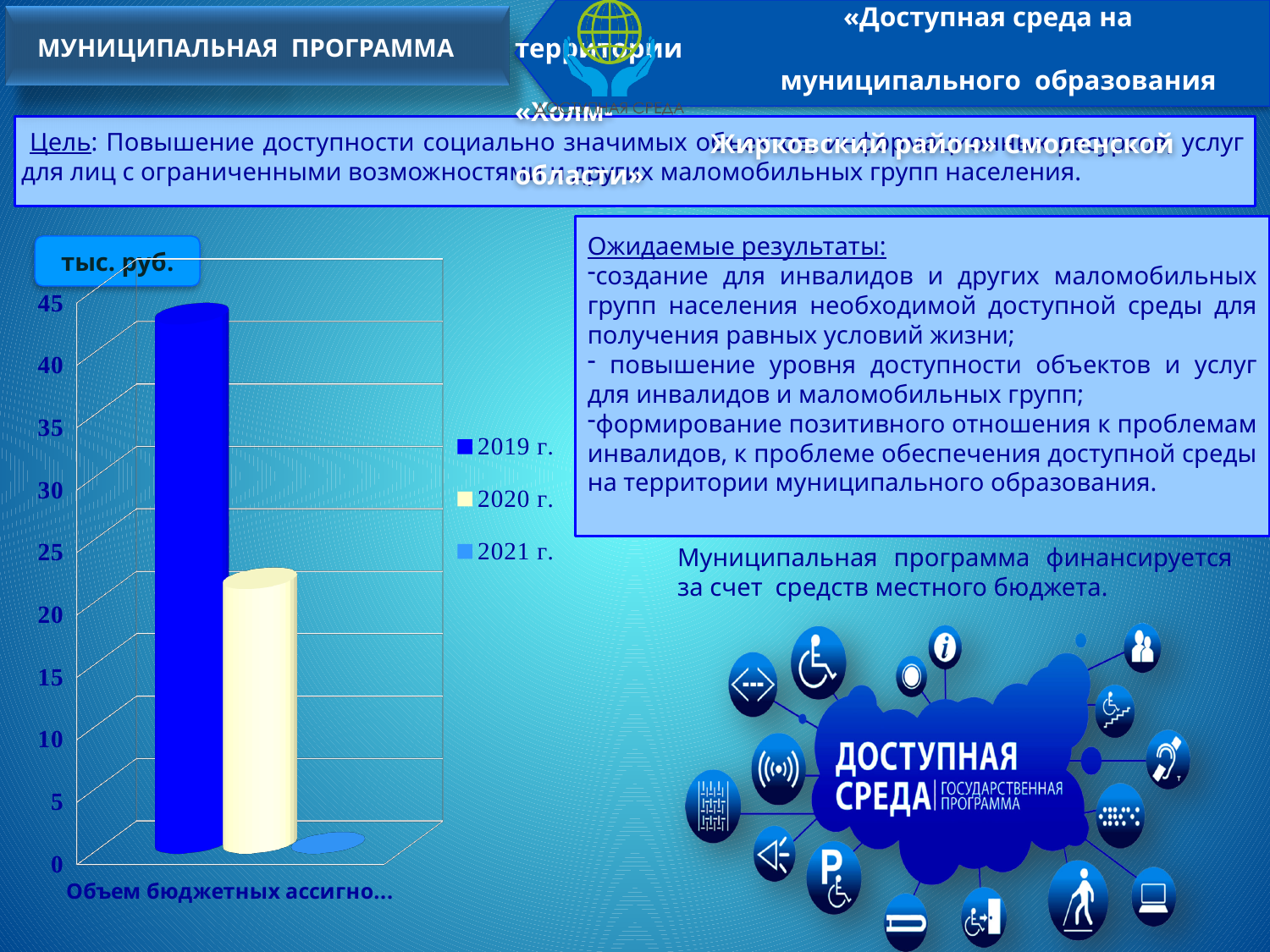
Which year has the lowest value in the chart? 2021 г. What kind of chart is shown on the slide? bar chart Which year has the highest value in the chart? 2019 г. How many series does the chart legend list? 3 Is the value for 2020 г. greater or less than 25? less What unit is shown in the label above the chart? тыс. руб. Is the value for 2020 г. greater or less than 20? greater Is the value for 2021 г. greater or less than 5? less Do the values rise or fall from 2019 г. to 2021 г.? fall Which is larger, the value for 2020 г. or the value for 2021 г.? 2020 г. Which is larger, the value for 2019 г. or the value for 2020 г.? 2019 г.